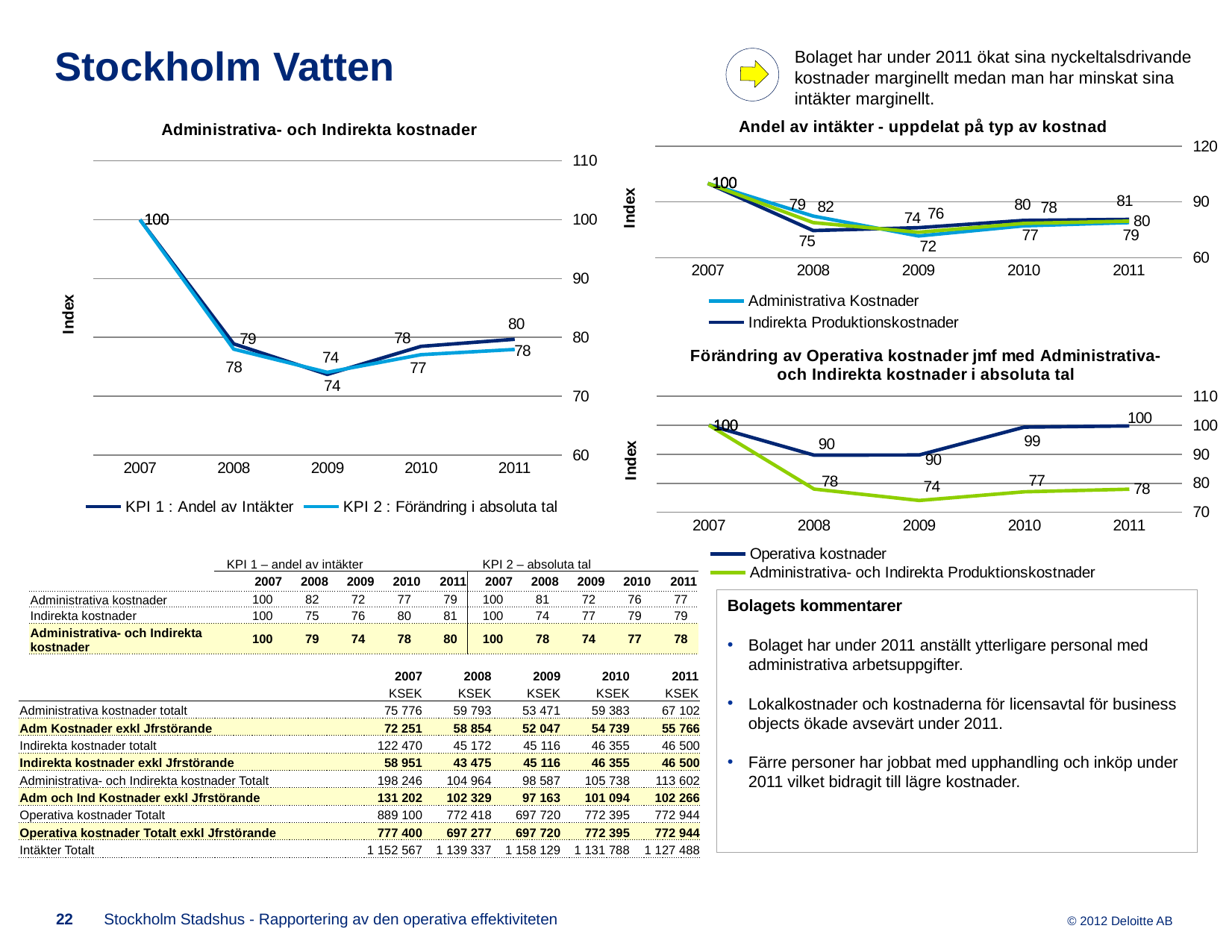
In the bottom-right chart 'Förändring av Operativa kostnader jmf med Administrativa- och Indirekta kostnader i absoluta tal', what is the value of Operativa kostnader in 2010? 99 In the chart 'Administrativa- och Indirekta kostnader', what is the difference between KPI 1 and KPI 2 in 2011? 2 In the chart 'Andel av intäkter - uppdelat på typ av kostnad', what is the value of Indirekta Produktionskostnader in 2011? 81 In the chart 'Administrativa- och Indirekta kostnader', what is the value of KPI 2 : Förändring i absoluta tal in 2010? 77 In the chart 'Administrativa- och Indirekta kostnader', how many series does the legend list? 2 What kind of chart is 'Administrativa- och Indirekta kostnader'? Line chart In the chart 'Administrativa- och Indirekta kostnader', what is the value of KPI 1 : Andel av Intäkter in 2011? 80 In the chart 'Administrativa- och Indirekta kostnader', in which year is KPI 1 : Andel av Intäkter lowest? 2009 How many years are shown on the x axis of the bottom-right chart 'Förändring av Operativa kostnader jmf med Administrativa- och Indirekta kostnader i absoluta tal'? 5 In the chart 'Andel av intäkter - uppdelat på typ av kostnad', what is the value of Administrativa Kostnader in 2009? 72 In the chart 'Andel av intäkter - uppdelat på typ av kostnad', which is larger in 2008: Administrativa Kostnader or Indirekta Produktionskostnader? Administrativa Kostnader In the bottom-right chart 'Förändring av Operativa kostnader jmf med Administrativa- och Indirekta kostnader i absoluta tal', what is the difference between Operativa kostnader and Administrativa- och Indirekta Produktionskostnader in 2009? 16